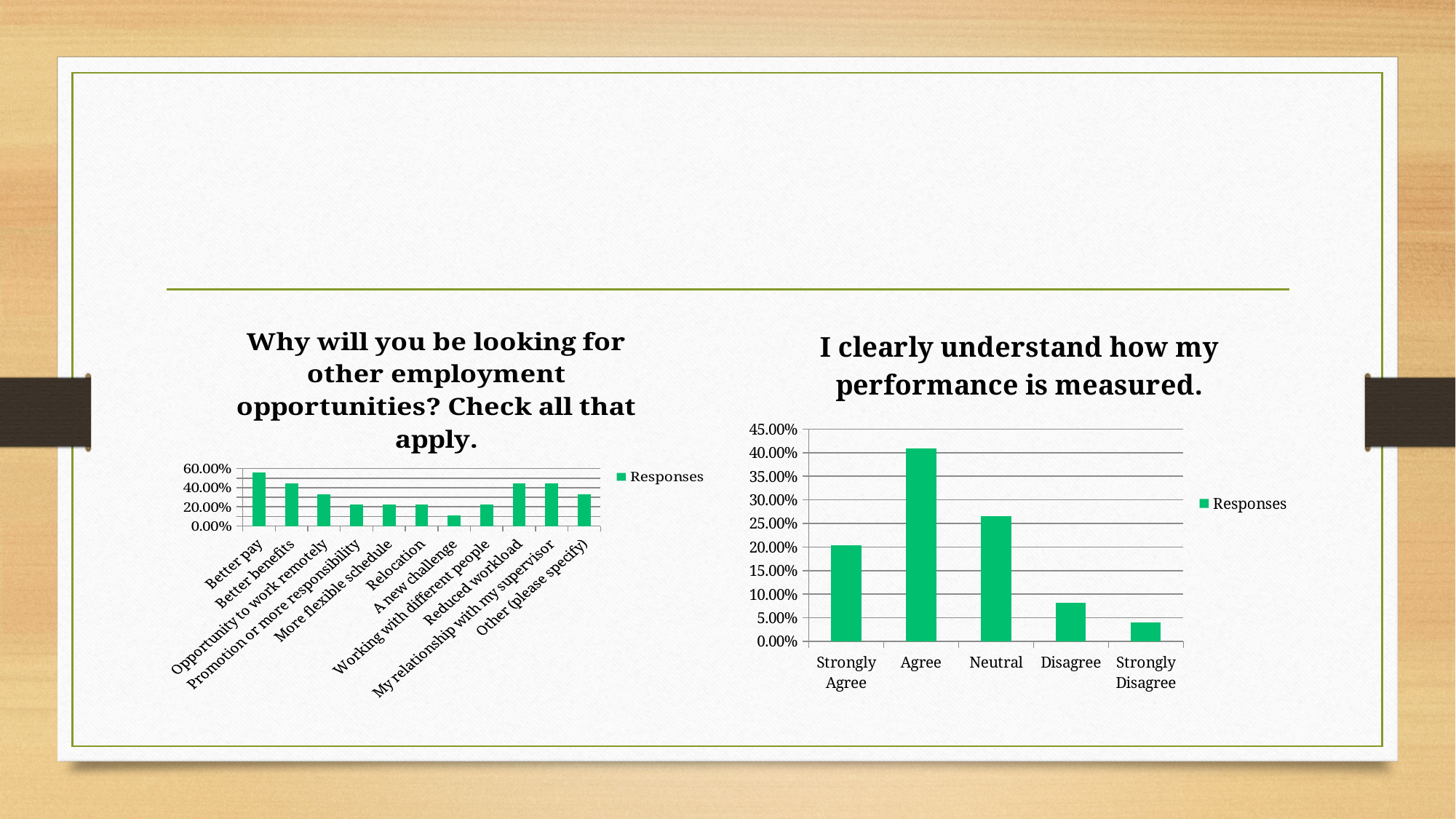
In the chart titled "I clearly understand how my performance is measured.", is the value for Disagree greater or less than 10.00%? less In the chart titled "I clearly understand how my performance is measured.", which category has the highest value? Agree In the chart titled "I clearly understand how my performance is measured.", how many categories are shown on the x axis? 5 In the chart titled "I clearly understand how my performance is measured.", how many series does the legend list? 1 In the chart titled "I clearly understand how my performance is measured.", which is larger, the value for Neutral or the value for Strongly Agree? Neutral In the chart on the left of the slide, which category has the highest value? Better pay What kind of chart is the chart titled "I clearly understand how my performance is measured."? bar chart In the chart on the left of the slide, is the value for Better pay greater or less than 40.00%? greater In the chart titled "I clearly understand how my performance is measured.", which category has the lowest value? Strongly Disagree In the chart on the left of the slide, which category has the lowest value? A new challenge In the chart on the left of the slide, how many categories are shown on the x axis? 11